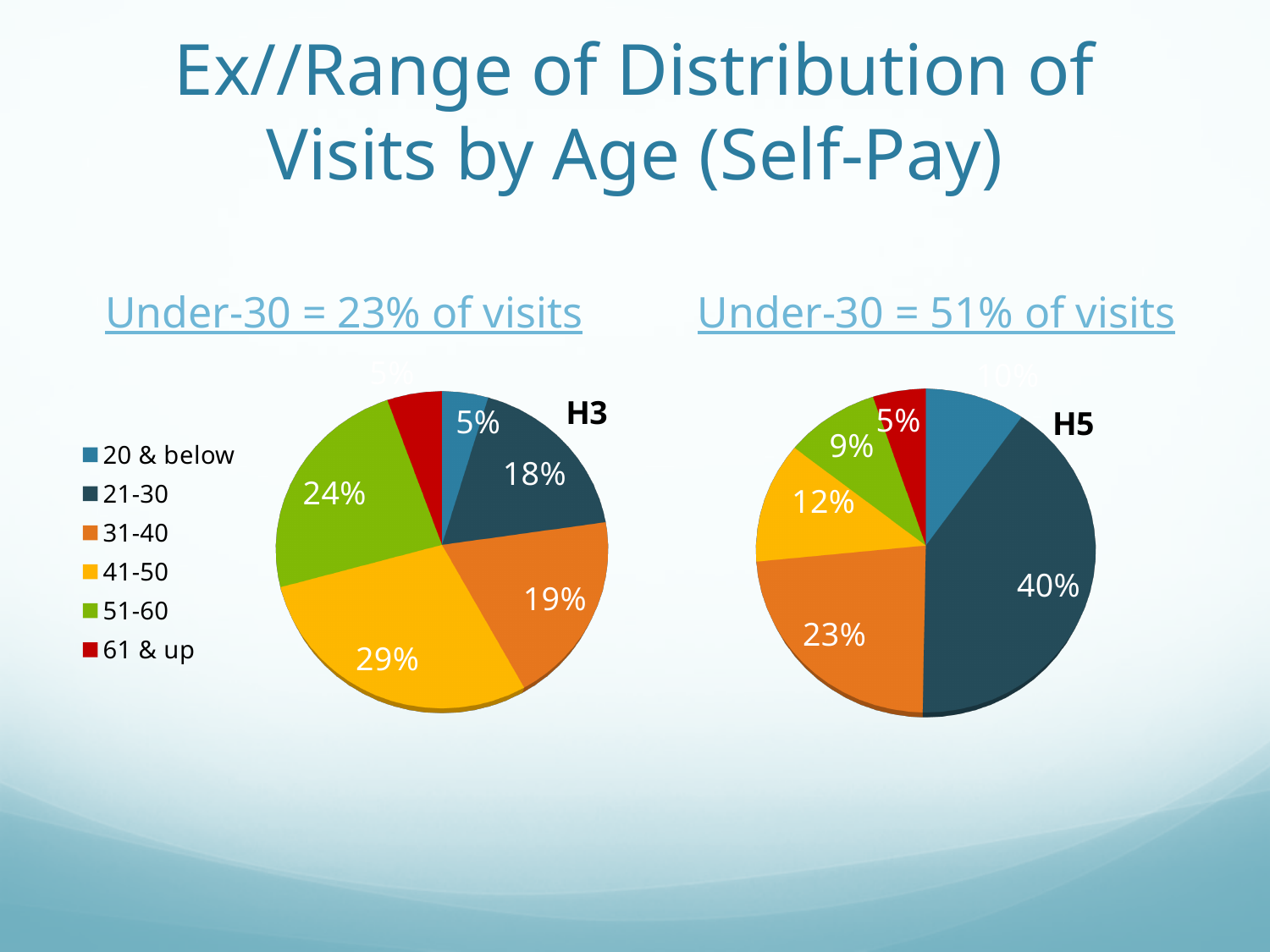
In the H3 pie chart, what share of visits is the 41-50 age group? 29% In the H5 pie chart, which age group has the smallest share of visits? 61 & up According to the text above the H5 chart, what share of visits are from patients under 30? 51% In the H3 pie chart, what share of visits is the 51-60 age group? 24% In the H5 pie chart, which age group has the largest share of visits? 21-30 In the H5 pie chart, how many percentage points larger is the 21-30 share than the 31-40 share? 17 percentage points How many age groups does the legend list? 6 In the H5 pie chart, what share of visits is the 31-40 age group? 23% In the H5 pie chart, what share of visits is the 21-30 age group? 40% In the H3 pie chart, which age group has the largest share of visits? 41-50 What kind of chart is used for H3 and H5? Pie chart In the H3 pie chart, which is larger: the 31-40 share or the 21-30 share? 31-40